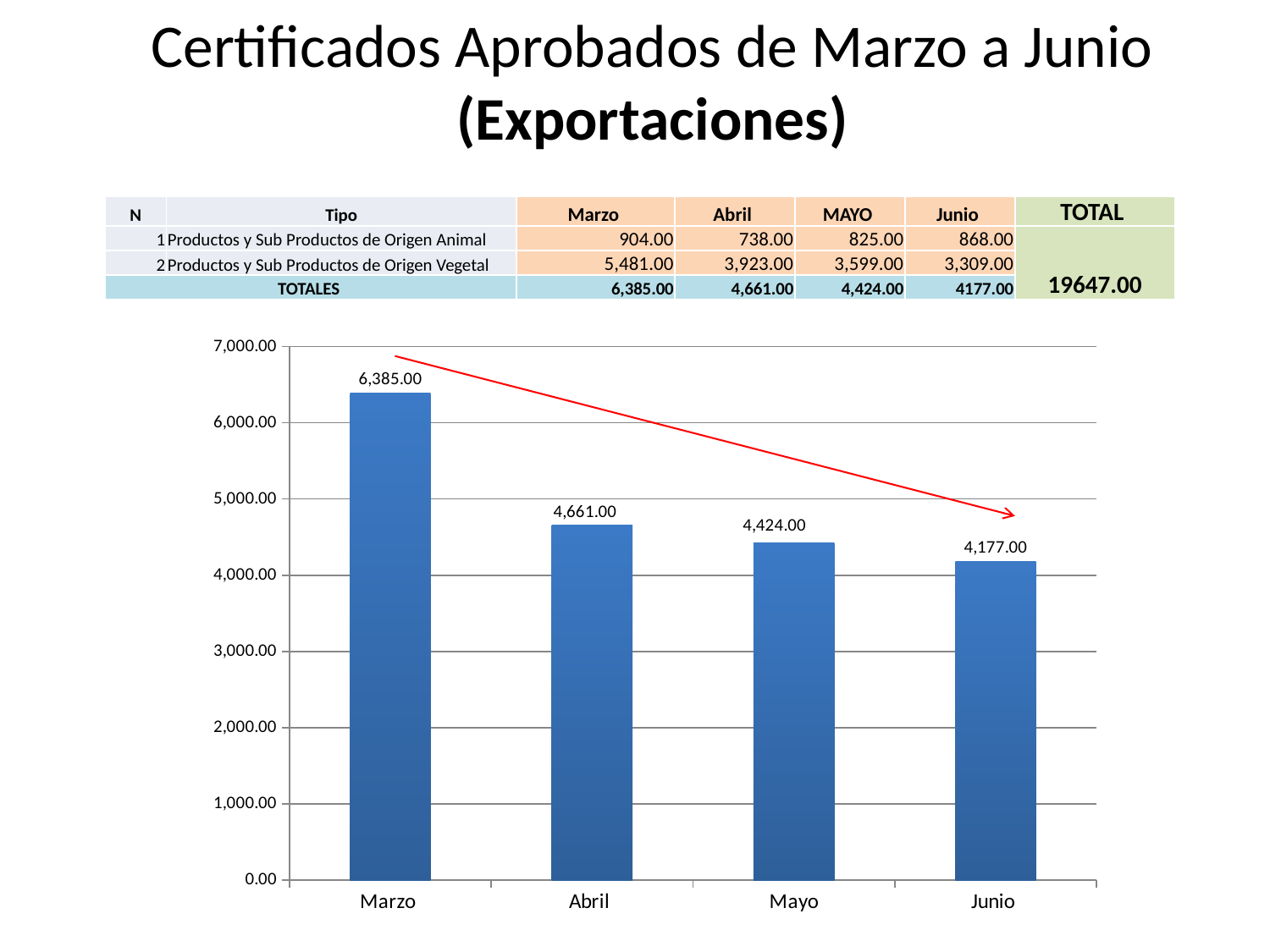
What is the difference between the values for Marzo and Abril? 1,724.00 Which month has the lowest value? Junio Which is larger, the value for Abril or the value for Mayo? Abril Do the values rise or fall from Marzo to Junio? fall What kind of chart is shown on the slide? bar chart How many months are shown on the x axis of the chart? 4 What is the value for Junio? 4,177.00 Which month has the highest value? Marzo Is the value for Mayo greater or less than 5,000.00? less What is the difference between the values for Mayo and Junio? 247.00 What is the value for Marzo? 6,385.00 What is the value for Abril? 4,661.00